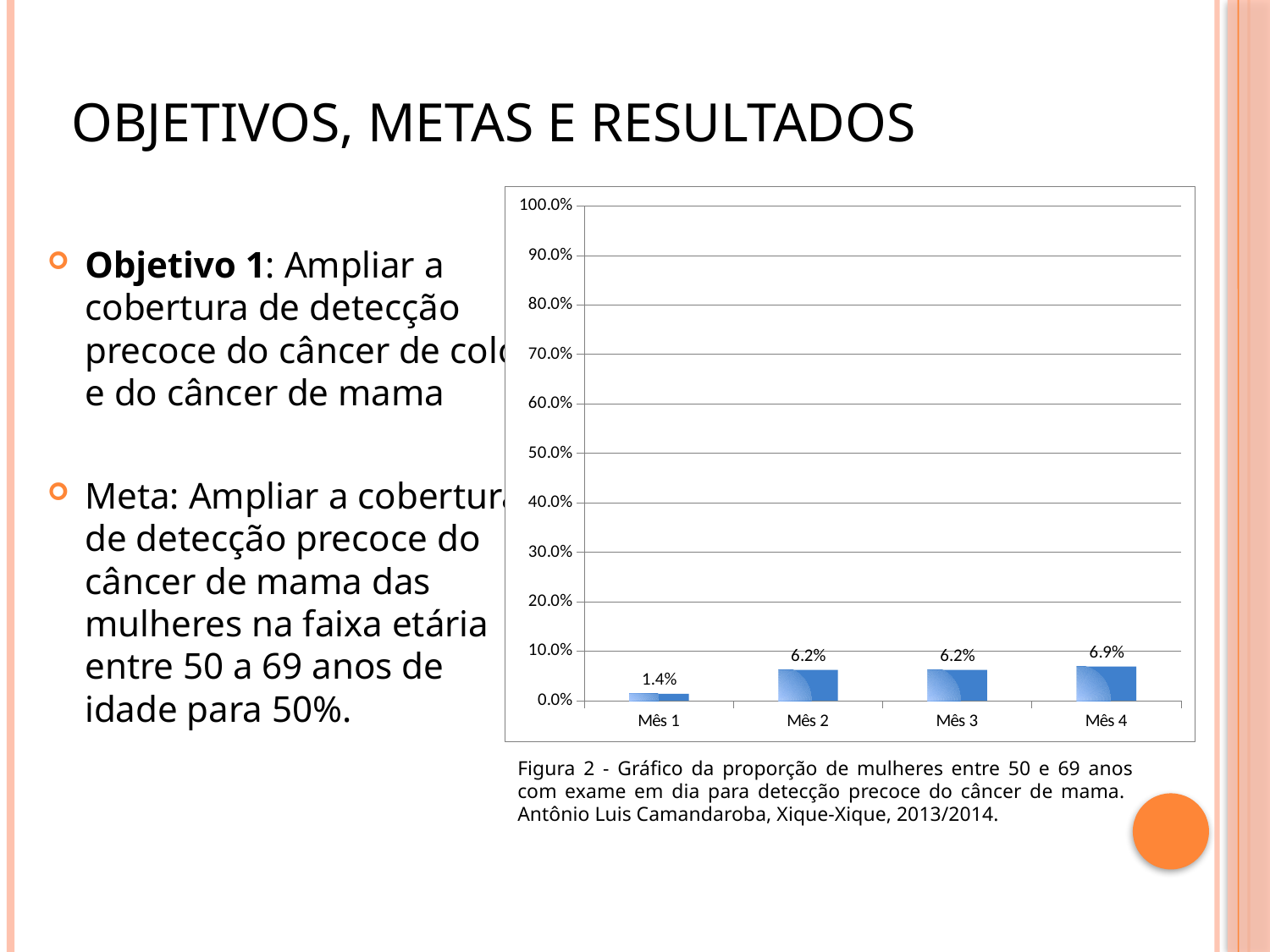
What is the value for Mês 4? 6.9% What is the value for Mês 1? 1.4% How many months are shown on the x axis? 4 What is the difference between the values for Mês 4 and Mês 1? 5.5% Is the value for Mês 4 greater or less than 10.0%? less Do the values generally rise or fall from Mês 1 to Mês 4? rise Which month has the highest value? Mês 4 What is the difference between the values for Mês 4 and Mês 3? 0.7% What is the value for Mês 2? 6.2% Which is larger, the value for Mês 1 or the value for Mês 2? Mês 2 Which month has the lowest value? Mês 1 What kind of chart is shown on the slide? bar chart